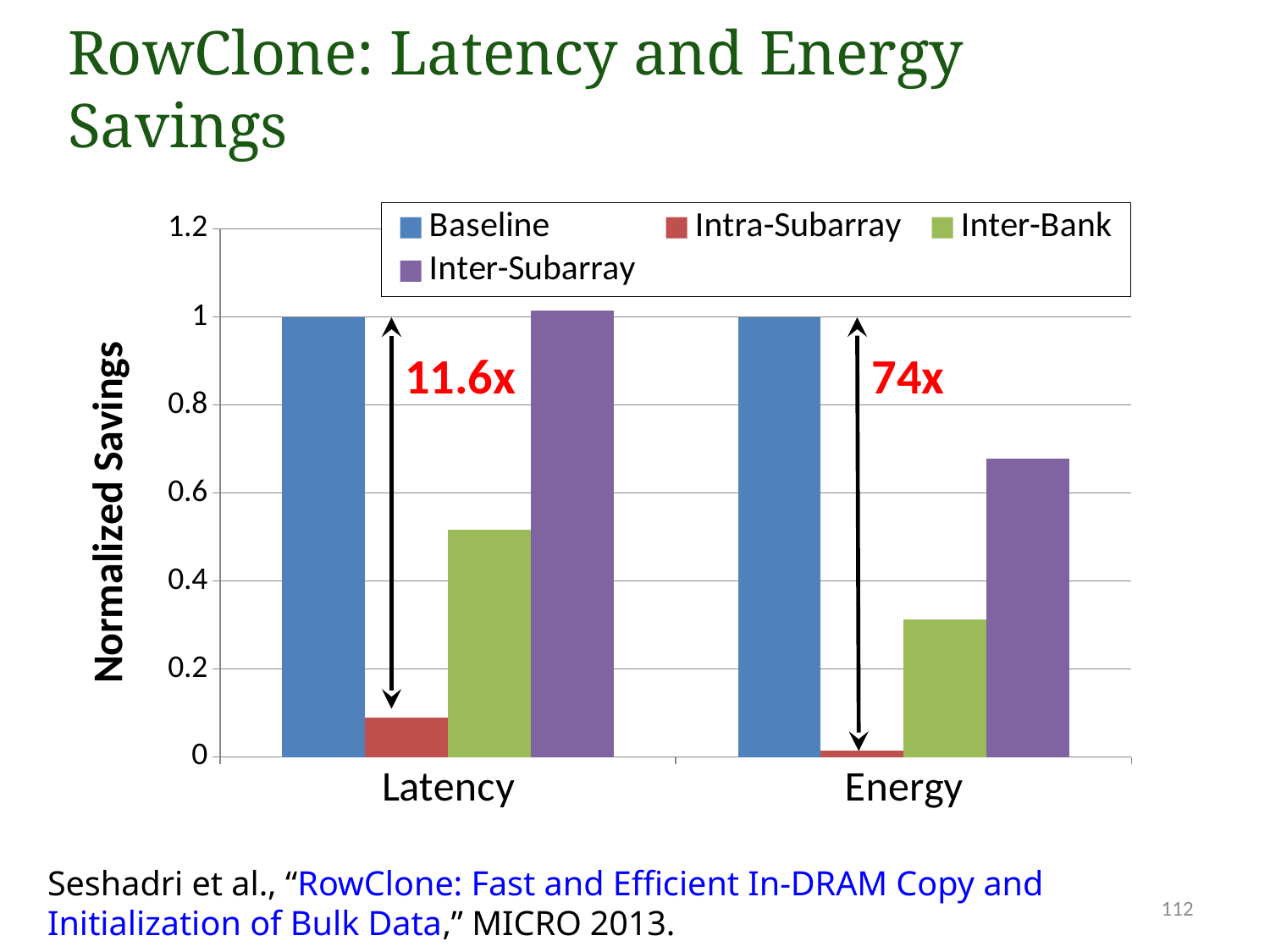
What is the Baseline value for Energy? 1 What improvement factor is annotated above the Energy bars? 74x How many categories are shown on the x axis? 2 Is the Intra-Subarray value for Latency greater or less than 0.2? less Is the Inter-Bank value for Energy greater or less than 0.4? less How many series does the legend list? 4 Is the Inter-Subarray value for Energy greater or less than 0.6? greater What kind of chart is shown on the slide? bar chart Which series has the lowest value for Energy? Intra-Subarray What is the Baseline value for Latency? 1 Which is larger: the Inter-Bank value for Latency or the Inter-Bank value for Energy? Latency